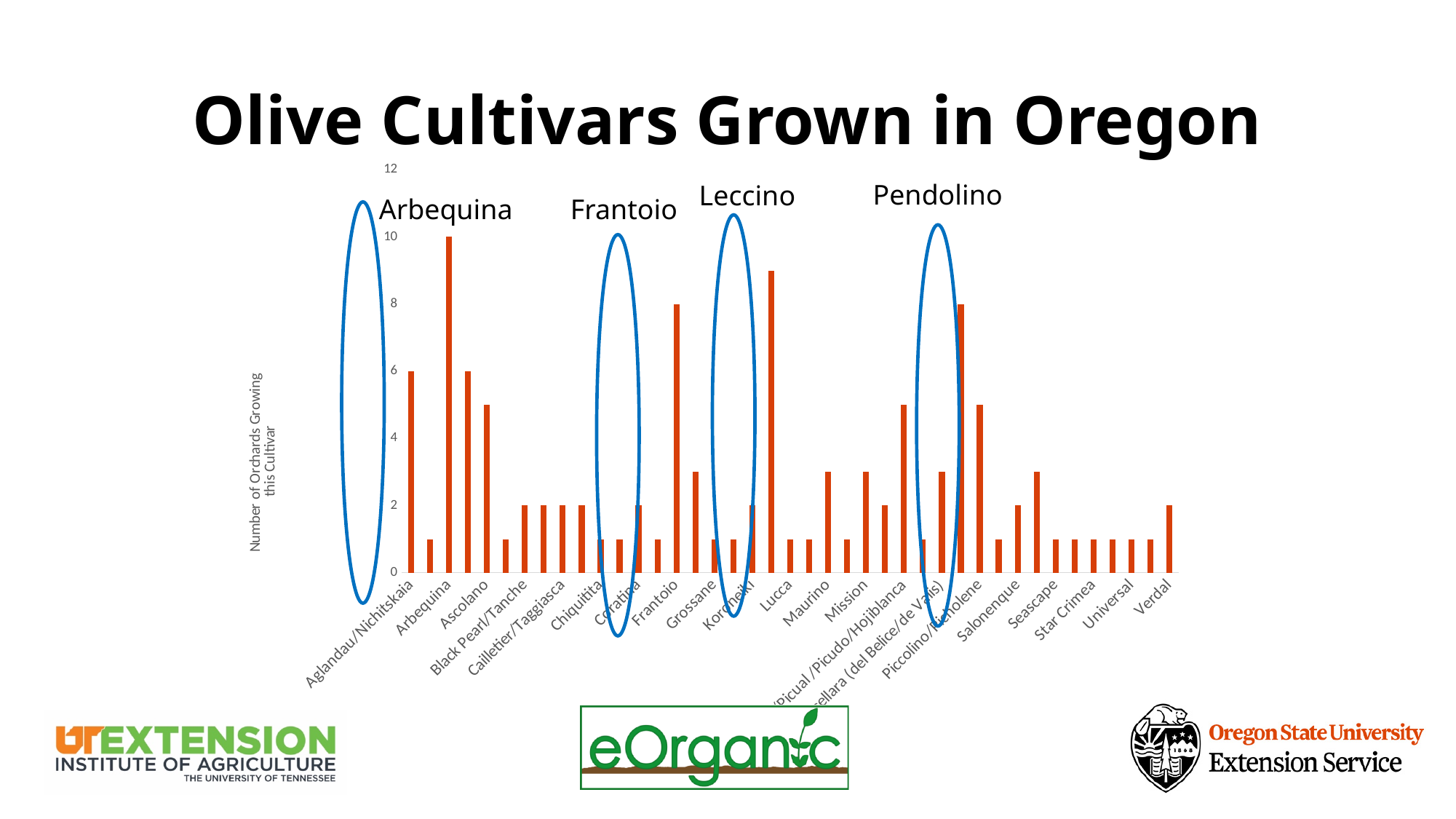
What type of chart is shown on the slide? bar chart Is the value for Maurino greater or less than 4? less How many orchards grow Arbequina according to the chart? 10 What is the title of the vertical axis? Number of Orchards Growing this Cultivar How many orchards grow Koroneiki? 2 Is the value for Ascolano greater or less than 4? greater What is the difference between the number of orchards growing Arbequina and the number growing Frantoio? 2 How many orchards grow Aglandau/Nichitskaia? 6 Which cultivar is grown by the most orchards? Arbequina How many orchards grow Frantoio according to the chart? 8 Which is grown by more orchards, Frantoio or Aglandau/Nichitskaia? Frantoio How many orchards grow Verdal? 2